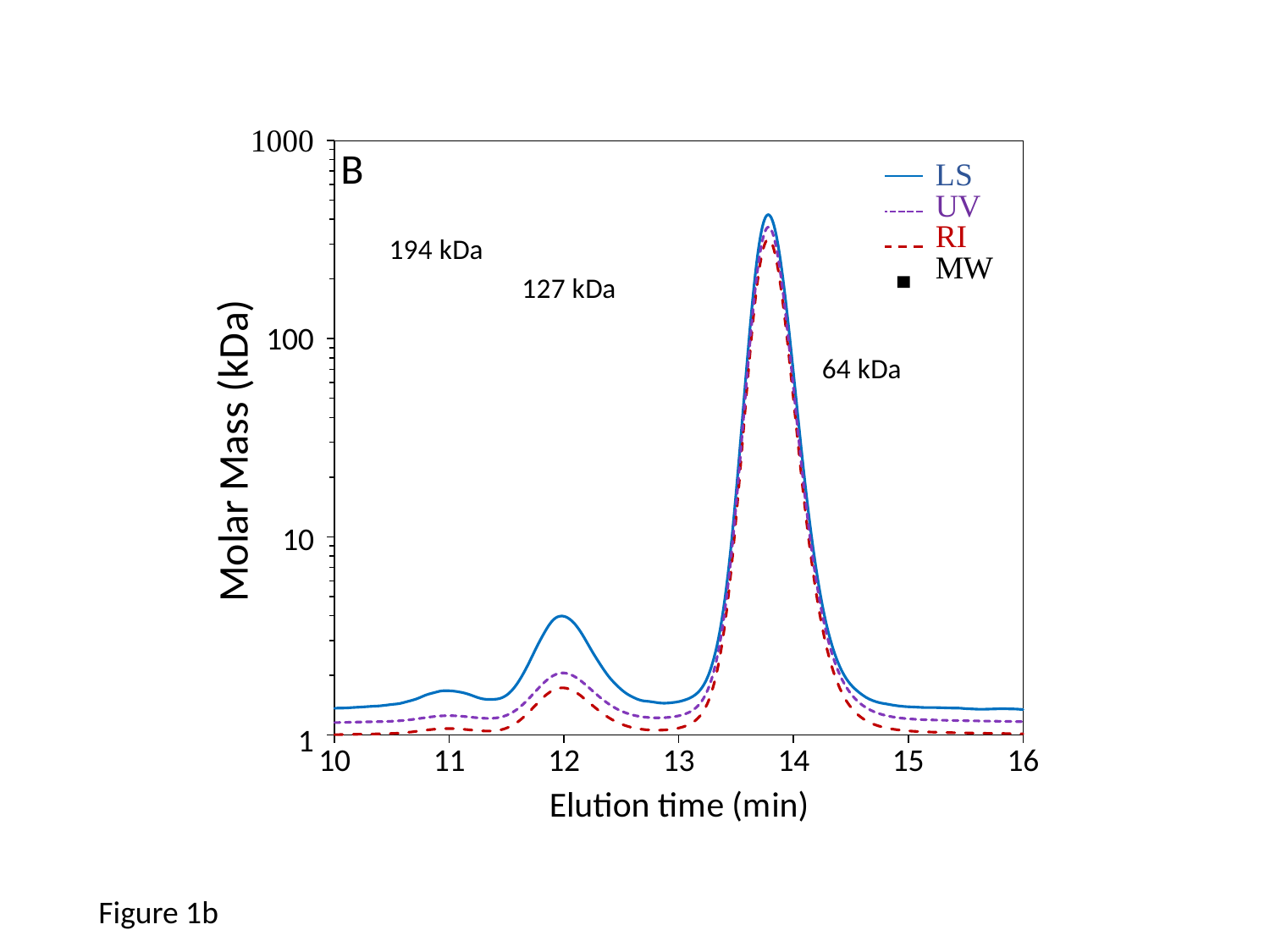
What molar mass is annotated next to the tallest peak? 64 kDa How many entries does the legend list? 4 Is the value of the LS series at 12 min greater or less than 10? less What colour is the RI series drawn in? red What molar mass is annotated near the peak at about 12 min? 127 kDa What kind of chart is shown on the slide? line chart Which series reaches the highest peak value? LS Is the peak value of the LS series near 14 min greater or less than 100? greater Which series has the lowest value at an elution time of 10 min? RI Between 14 and 15 min, do the curves rise or fall? fall At an elution time of 12 min, which is larger, the LS value or the RI value? LS What is the title of the x axis? Elution time (min)